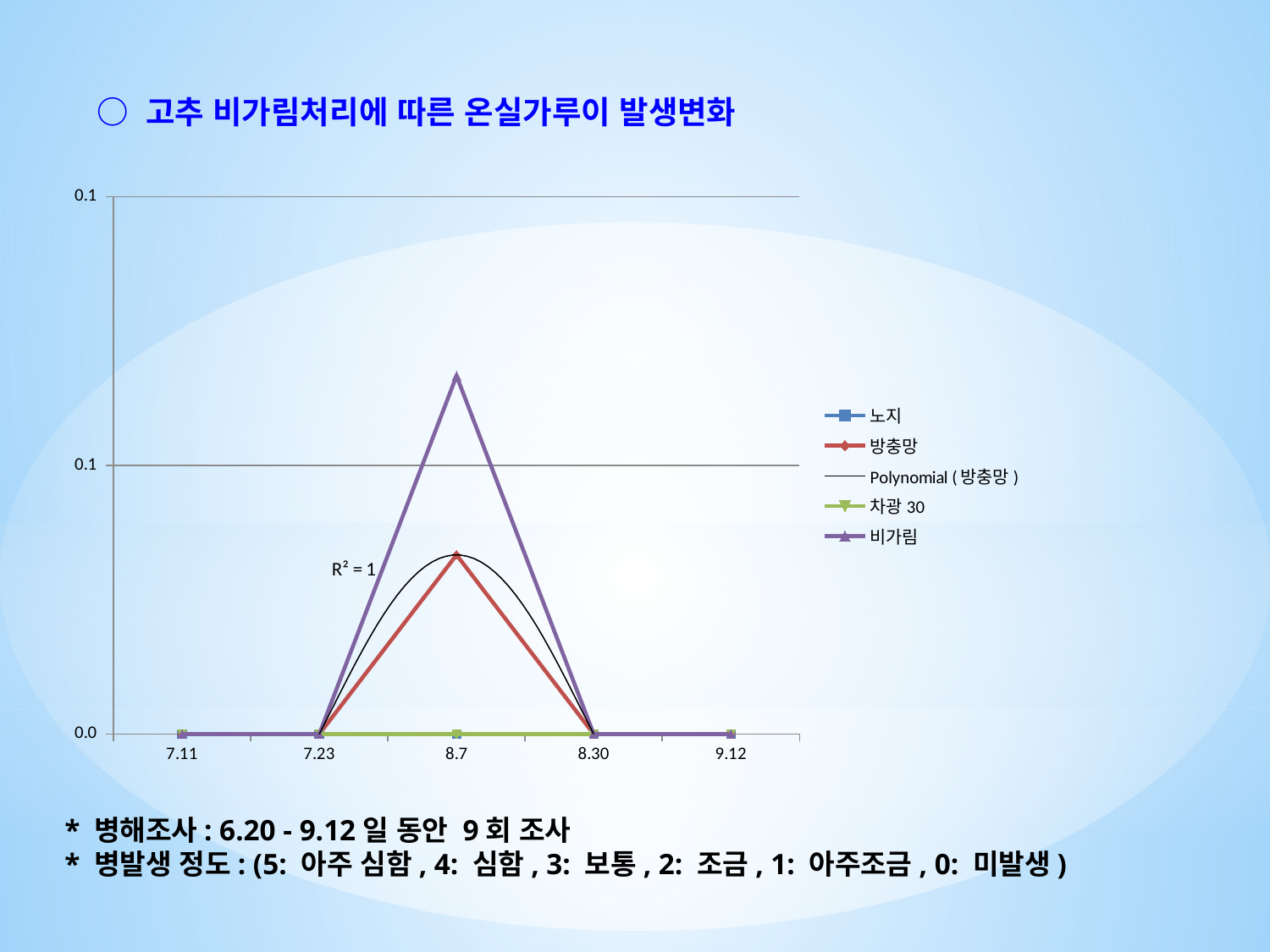
How many entries does the chart legend list? 5 At 8.7, which series has the larger value, 비가림 or 방충망? 비가림 Which series reaches the highest peak in the chart? 비가림 At which date does 비가림 reach its highest value? 8.7 What is the title of the chart on the slide? 고추 비가림처리에 따른 온실가루이 발생변화 What kind of chart is shown on the slide? line chart What is the value for 방충망 at 9.12? 0.0 Does the value for 비가림 rise or fall from 8.7 to 8.30? fall What R² value is printed on the chart? R² = 1 How many dates are shown on the x axis of the chart? 5 What is the value for 비가림 at 7.23? 0.0 What is the value for 노지 at 8.7? 0.0